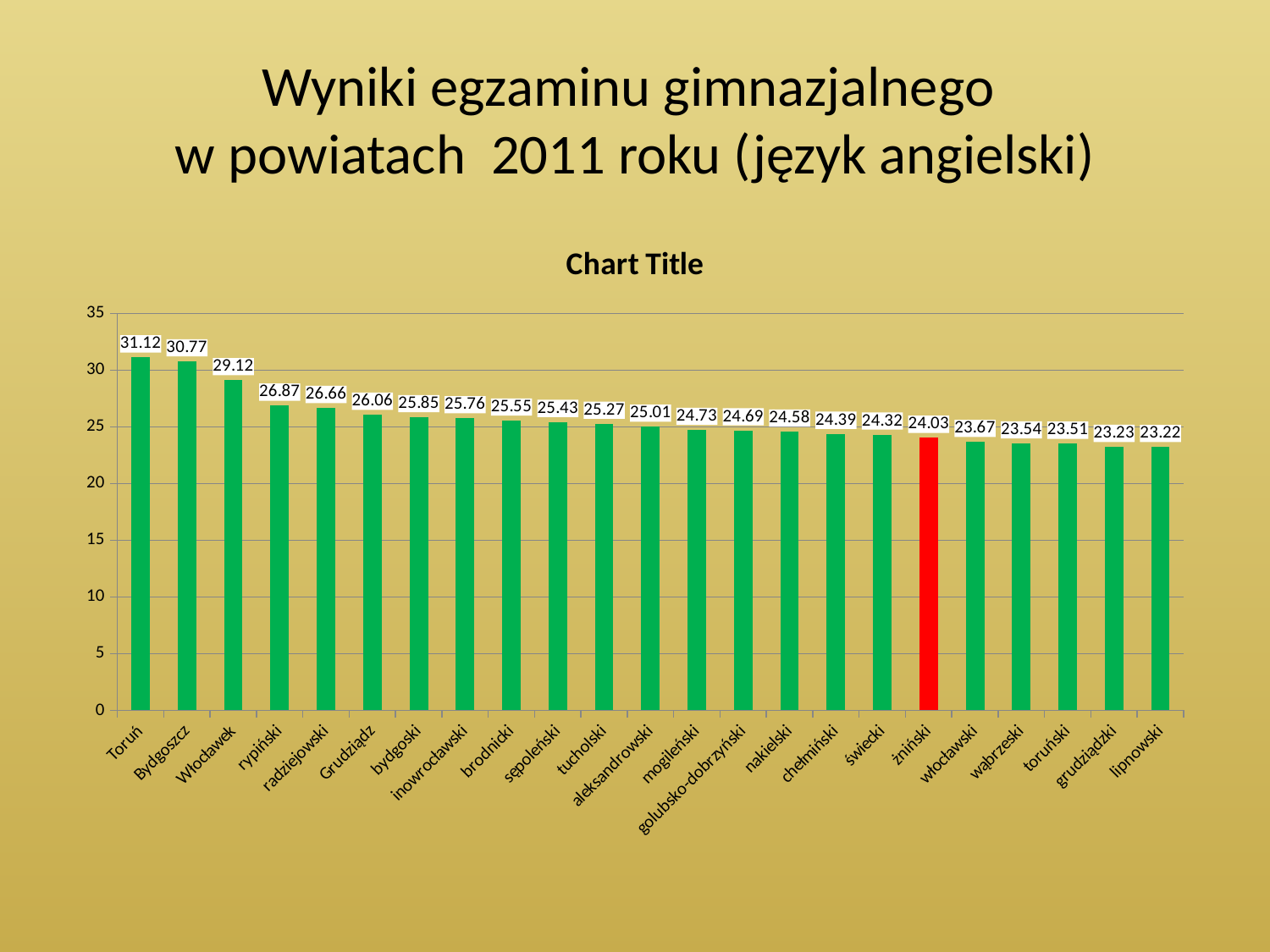
What is the value for Grudziądz? 26.06 Which category's bar is coloured red? żniński How many categories are shown on the x axis? 23 What is the value for Toruń? 31.12 Which category has the highest value? Toruń What is the difference between the values for Toruń and Bydgoszcz? 0.35 Which category has the lowest value? lipnowski What is the difference between the values for Włocławek and włocławski? 5.45 What is the value for żniński? 24.03 Which is larger, the value for rypiński or the value for radziejowski? rypiński What kind of chart is shown on the slide? bar chart Is the value for Włocławek greater or less than 30? less